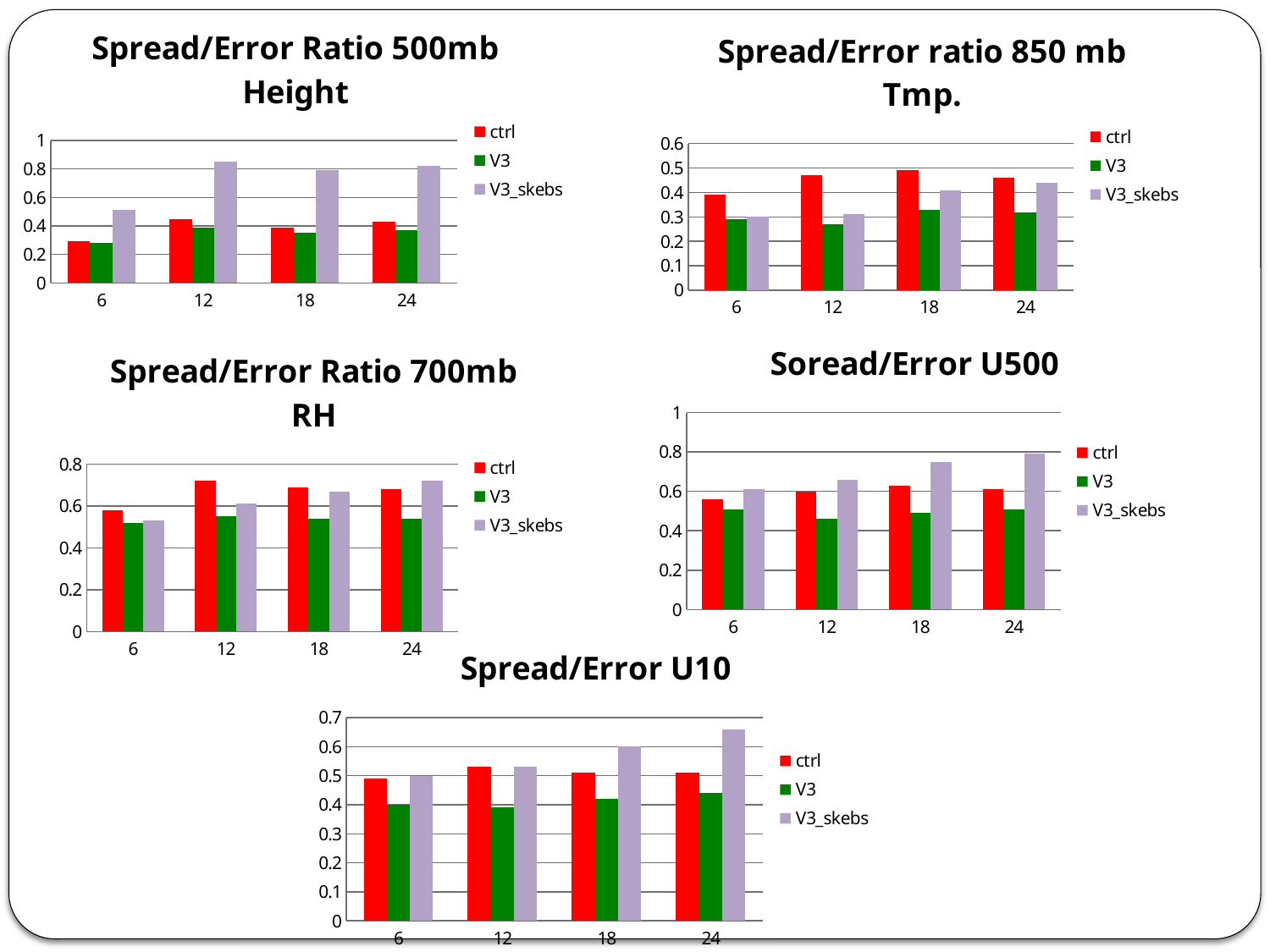
In the "Soread/Error U500" chart, do the V3_skebs values rise or fall from 6 to 24? rise In the "Spread/Error ratio 850 mb Tmp." chart, is the V3 value at 12 greater or less than 0.3? less In the "Spread/Error Ratio 700mb RH" chart, is the ctrl value at 12 greater or less than 0.6? greater Which colour represents the V3 series in the "Spread/Error U10" chart? green In the "Spread/Error U10" chart, which is larger at 24: ctrl or V3_skebs? V3_skebs In the "Spread/Error Ratio 500mb Height" chart, is the V3_skebs value at 12 greater or less than 0.8? greater How many categories are shown on the x axis of the "Soread/Error U500" chart? 4 In the "Spread/Error Ratio 500mb Height" chart, at which x-axis category is the V3_skebs bar highest? 12 What type of chart is the "Spread/Error Ratio 500mb Height" chart? bar chart How many series does the legend of the "Spread/Error U10" chart list? 3 In the "Spread/Error Ratio 700mb RH" chart, which is larger at 12: ctrl or V3_skebs? ctrl